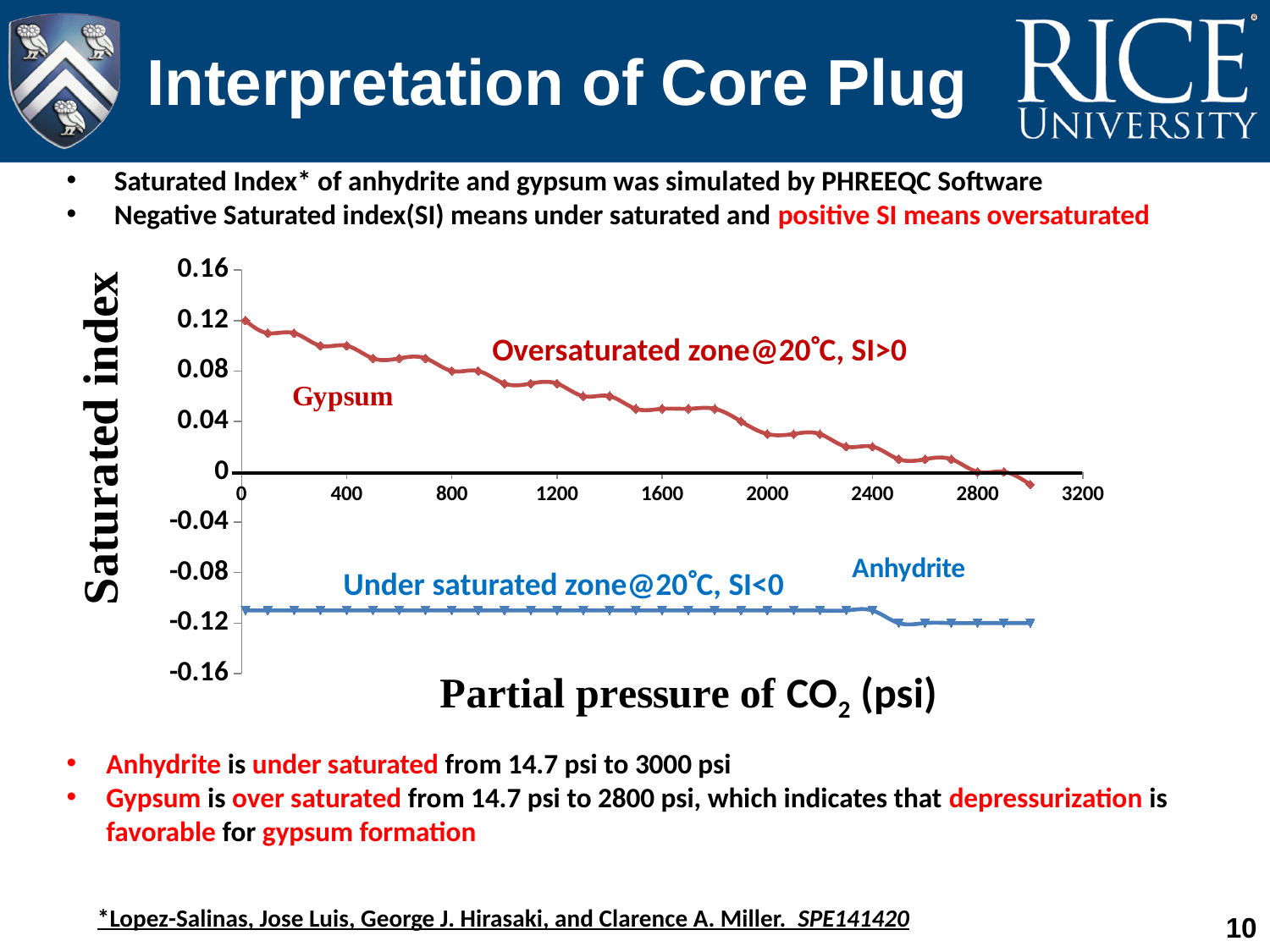
Is the Anhydrite saturated index at 1600 psi greater or less than 0? less Which two series are labelled on the chart? Gypsum and Anhydrite Is the Gypsum saturated index at 2000 psi greater or less than 0? greater What is the title of the x axis? Partial pressure of CO2 (psi) Is the Anhydrite saturated index at 800 psi greater or less than -0.08? less What kind of chart is shown on the slide? line chart How many data series are plotted on the chart? 2 Does the Gypsum saturated index rise or fall as the partial pressure of CO2 increases? fall Which series has the higher saturated index at 1600 psi, Gypsum or Anhydrite? Gypsum Which series has the lowest saturated index across the chart? Anhydrite